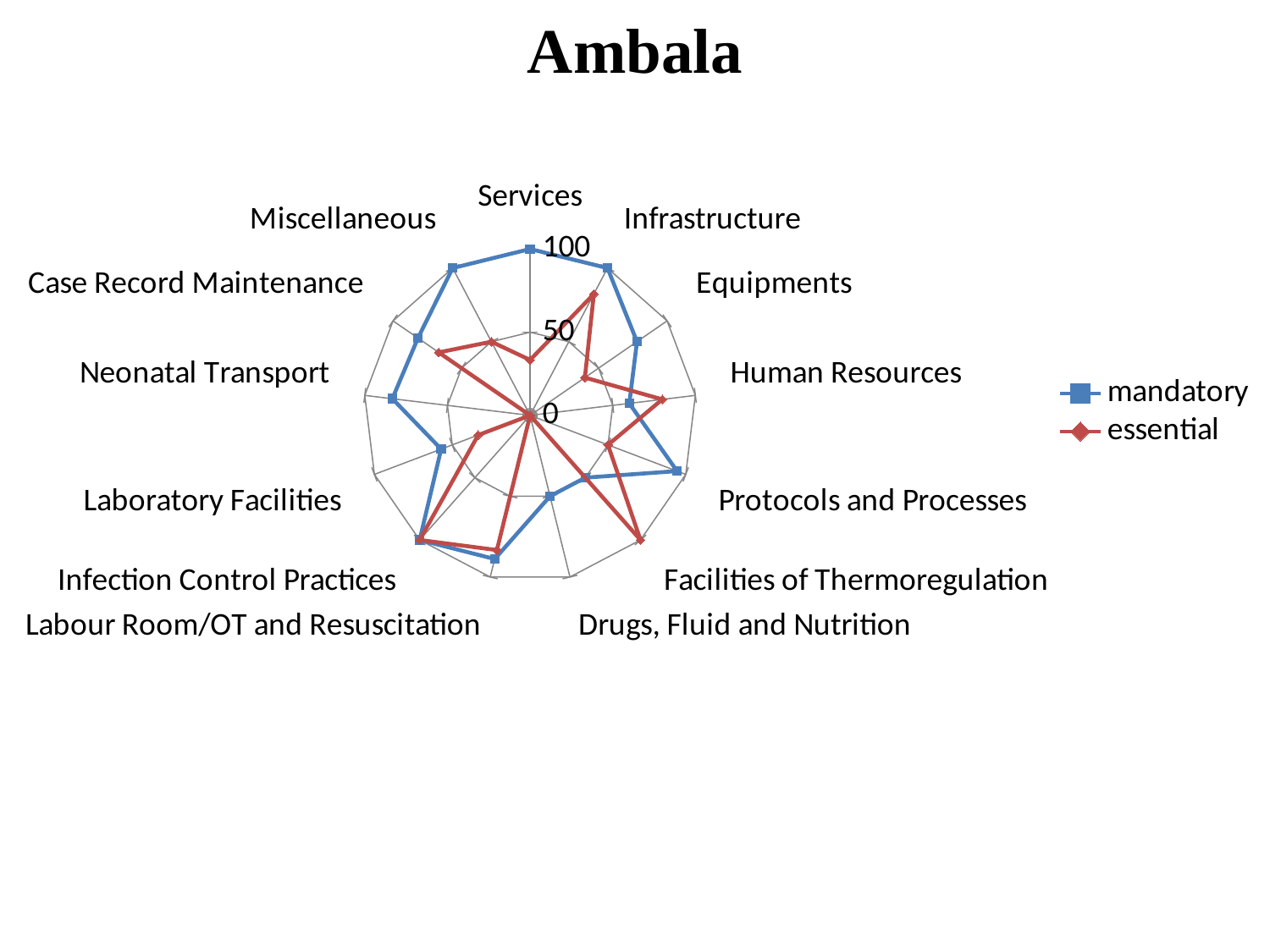
For Equipments, which series has the larger value, mandatory or essential? mandatory Is the essential value for Equipments greater or less than 50? less Is the mandatory value for Neonatal Transport greater or less than 50? greater How many series does the legend list? 2 How many categories are plotted around the radar chart? 13 For Facilities of Thermoregulation, which series has the larger value, mandatory or essential? essential What is the title of the chart? Ambala Is the mandatory value for Services greater or less than 50? greater What kind of chart is shown on the slide? radar chart Which colour represents the essential series in the legend? red